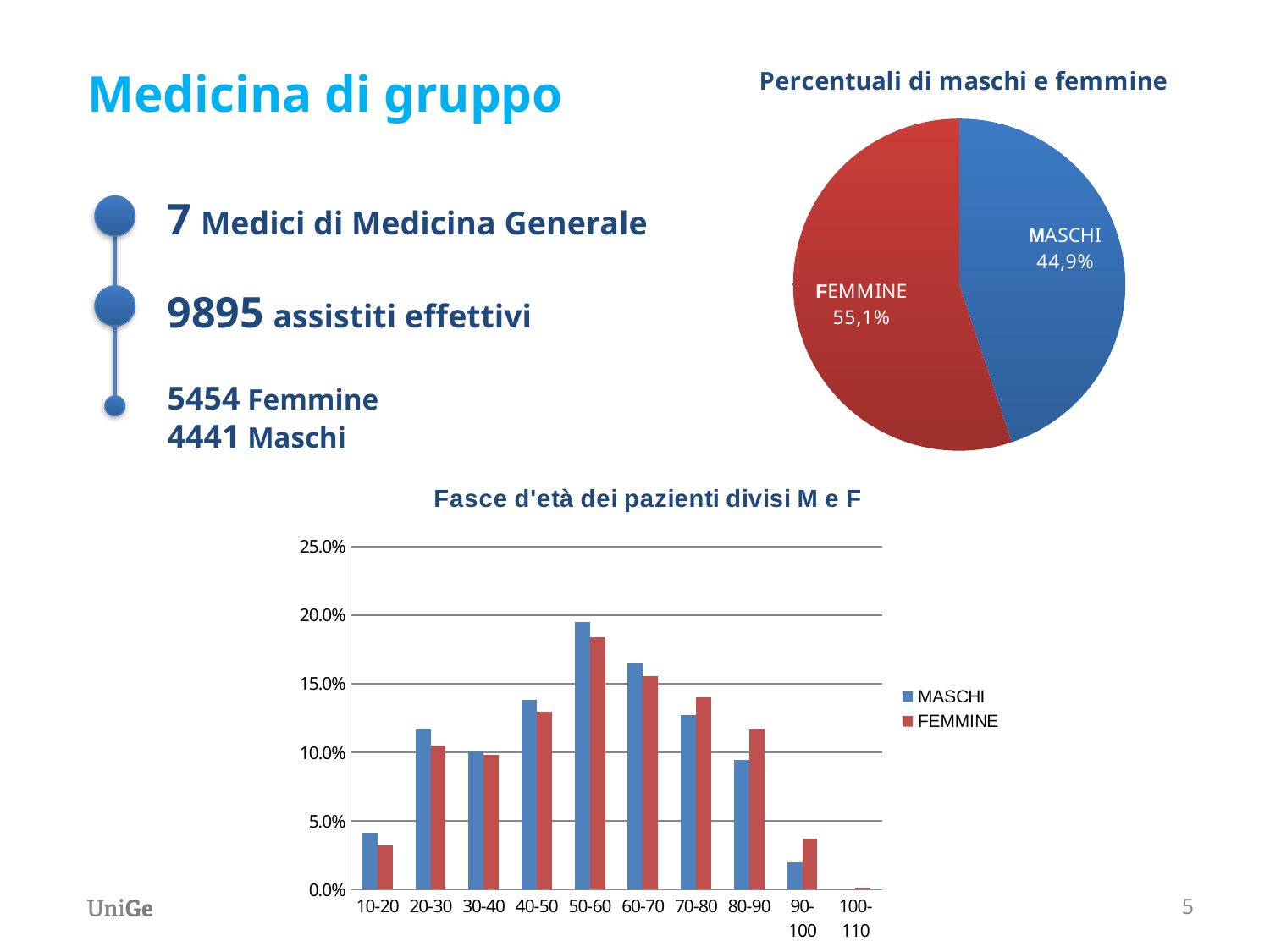
In the chart 'Fasce d'età dei pazienti divisi M e F', how many age categories are shown on the x axis? 10 In the chart 'Fasce d'età dei pazienti divisi M e F', is the FEMMINE value for 90-100 greater or less than 5.0%? less In the chart 'Fasce d'età dei pazienti divisi M e F', which age category has the highest FEMMINE value? 50-60 In the chart 'Fasce d'età dei pazienti divisi M e F', which series is larger for the 80-90 category, MASCHI or FEMMINE? FEMMINE What kind of chart is 'Fasce d'età dei pazienti divisi M e F'? Bar chart In the pie chart 'Percentuali di maschi e femmine', what percentage is shown for MASCHI? 44,9% In the pie chart 'Percentuali di maschi e femmine', which slice is larger, MASCHI or FEMMINE? FEMMINE In the pie chart 'Percentuali di maschi e femmine', how many slices are there? 2 In the chart 'Fasce d'età dei pazienti divisi M e F', how many series does the legend list? 2 In the pie chart 'Percentuali di maschi e femmine', what percentage is shown for FEMMINE? 55,1% In the chart 'Fasce d'età dei pazienti divisi M e F', is the MASCHI value for 50-60 greater or less than 15.0%? greater In the chart 'Fasce d'età dei pazienti divisi M e F', which age category has the highest MASCHI value? 50-60